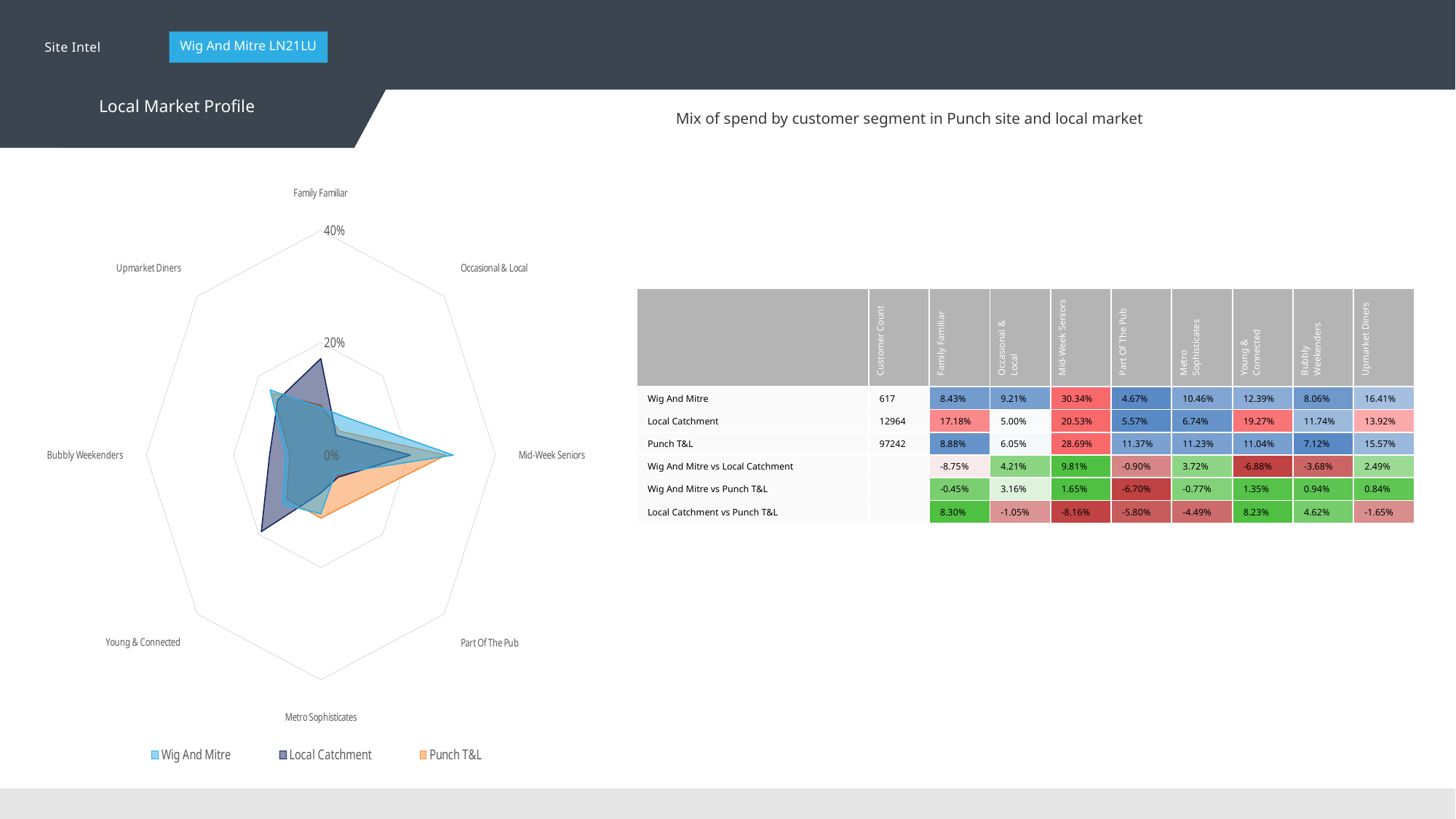
What is the highest percentage tick shown on the radar chart's axis? 40% How many series does the radar chart's legend list? 3 In the radar chart, is the Local Catchment value for Family Familiar greater or less than 20%? less How many customer segments (axes) does the radar chart have? 8 For which segment does the Wig And Mitre series reach its highest value in the radar chart? Mid-Week Seniors What kind of chart is shown on the left of the slide? Radar chart In the radar chart, is the Wig And Mitre value for Mid-Week Seniors greater or less than 20%? greater Which series in the radar chart is shown in orange? Punch T&L For which segment does the Punch T&L series reach its highest value in the radar chart? Mid-Week Seniors For which segment does the Wig And Mitre series have its lowest value in the radar chart? Part Of The Pub For Young & Connected, which series has the larger value in the radar chart: Wig And Mitre or Local Catchment? Local Catchment What is the Wig And Mitre share of spend for Mid-Week Seniors, as printed in the table? 30.34%